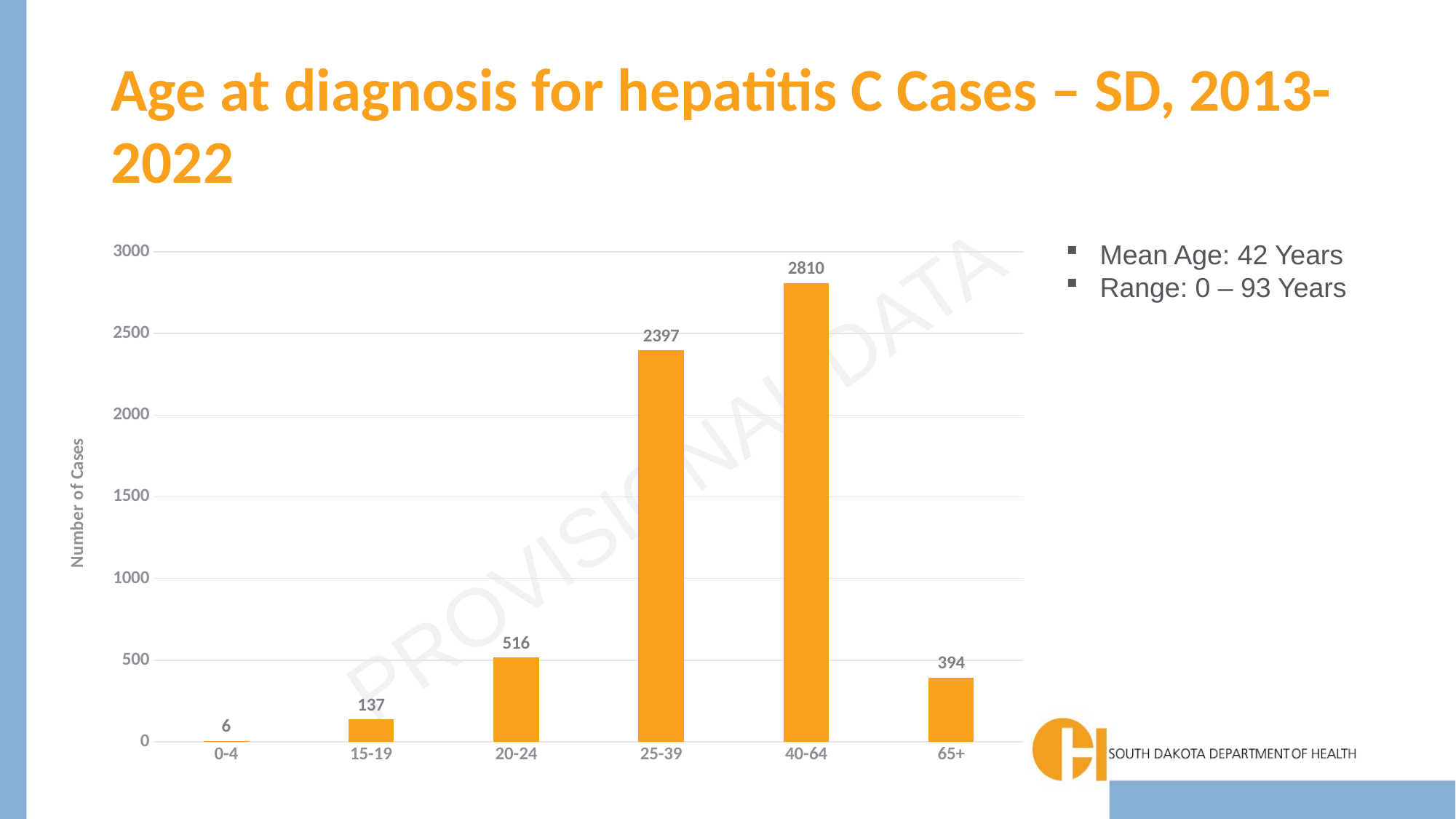
What is the difference in cases between the 40-64 and 25-39 age groups? 413 Which age group has the highest number of cases? 40-64 Which age group has more cases, 20-24 or 65+? 20-24 What type of chart is shown on the slide? Bar chart What is the difference in cases between the 20-24 and 15-19 age groups? 379 What is the number of cases for the 65+ age group? 394 How many age groups are shown on the x axis? 6 What is the label of the vertical axis? Number of Cases What is the number of cases for the 25-39 age group? 2397 Which age group has the lowest number of cases? 0-4 How many hepatitis C cases were diagnosed in the 40-64 age group? 2810 How many cases are shown for the 0-4 age group? 6